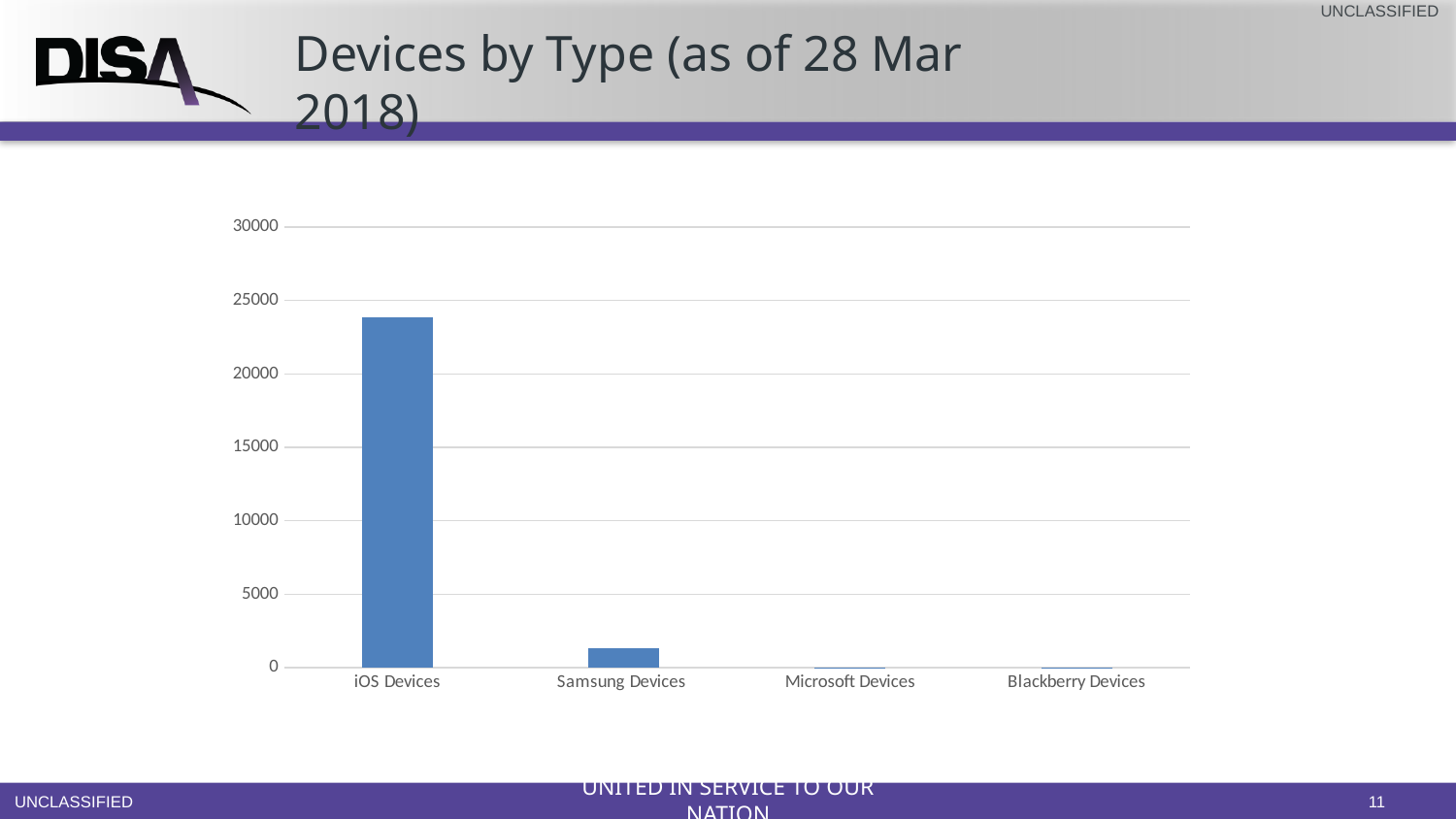
Is the value for Samsung Devices greater or less than 5000? less Which device category has the highest value? iOS Devices How many device categories are plotted on the chart? 4 Is the value for Microsoft Devices greater or less than 5000? less Is the value for iOS Devices greater or less than 20000? greater What is the highest tick value shown on the vertical axis? 30000 Which is larger, the value for Samsung Devices or the value for Blackberry Devices? Samsung Devices Which is larger, the value for iOS Devices or the value for Samsung Devices? iOS Devices What is the title of the slide containing the chart? Devices by Type (as of 28 Mar 2018) What kind of chart is shown on the slide? bar chart